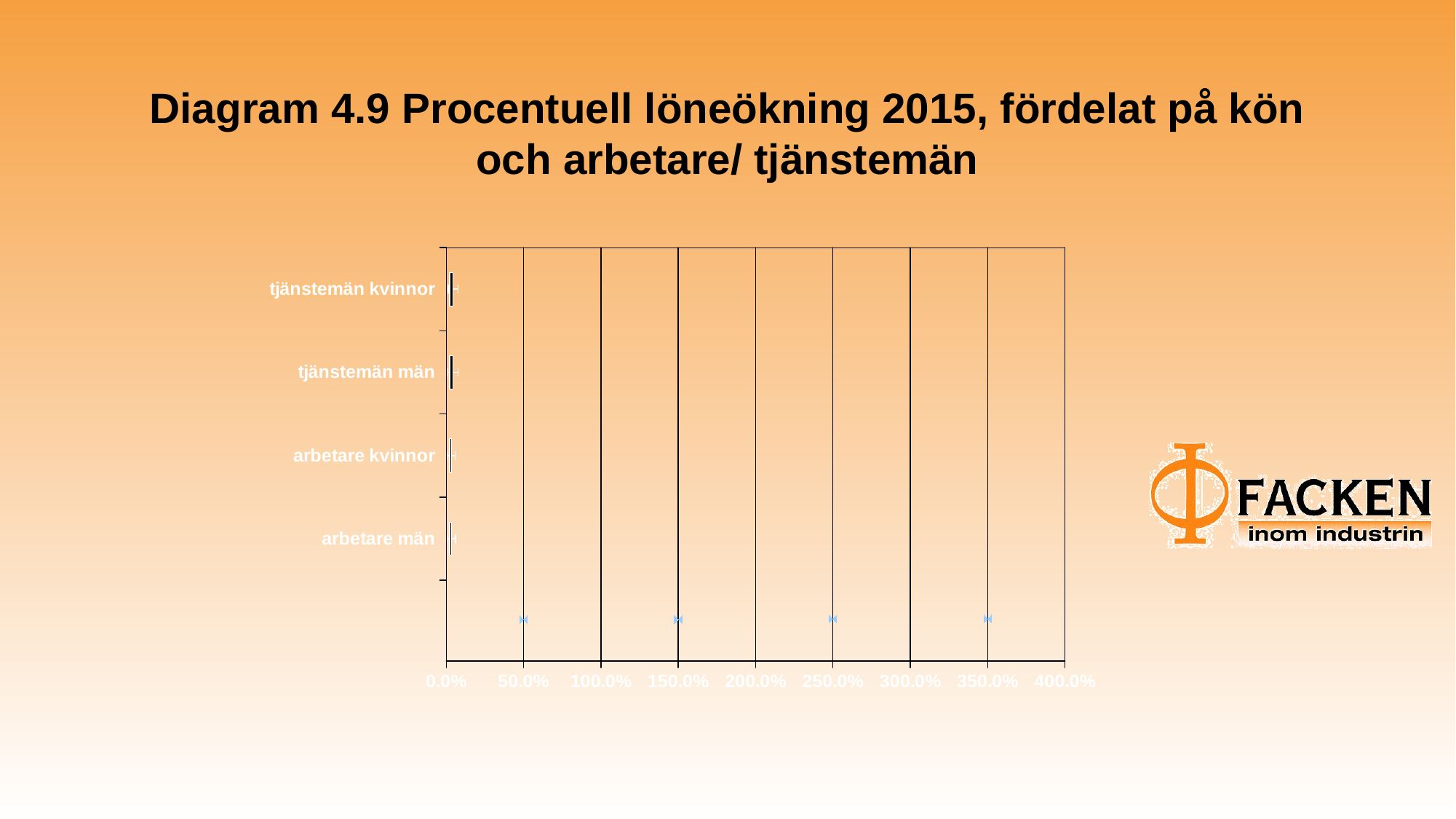
Is the value for arbetare kvinnor greater or less than 100.0%? less Is the value for tjänstemän kvinnor greater or less than 50.0%? less Which category is listed at the bottom of the chart's vertical axis? arbetare män What is the title of the chart on the slide? Diagram 4.9 Procentuell löneökning 2015, fördelat på kön och arbetare/ tjänstemän How many categories are shown on the chart's vertical axis? 4 Is the value for tjänstemän män greater or less than 50.0%? less What kind of chart is shown on the slide? bar chart What is the highest value shown on the chart's horizontal axis? 400.0% Which category is listed at the top of the chart's vertical axis? tjänstemän kvinnor